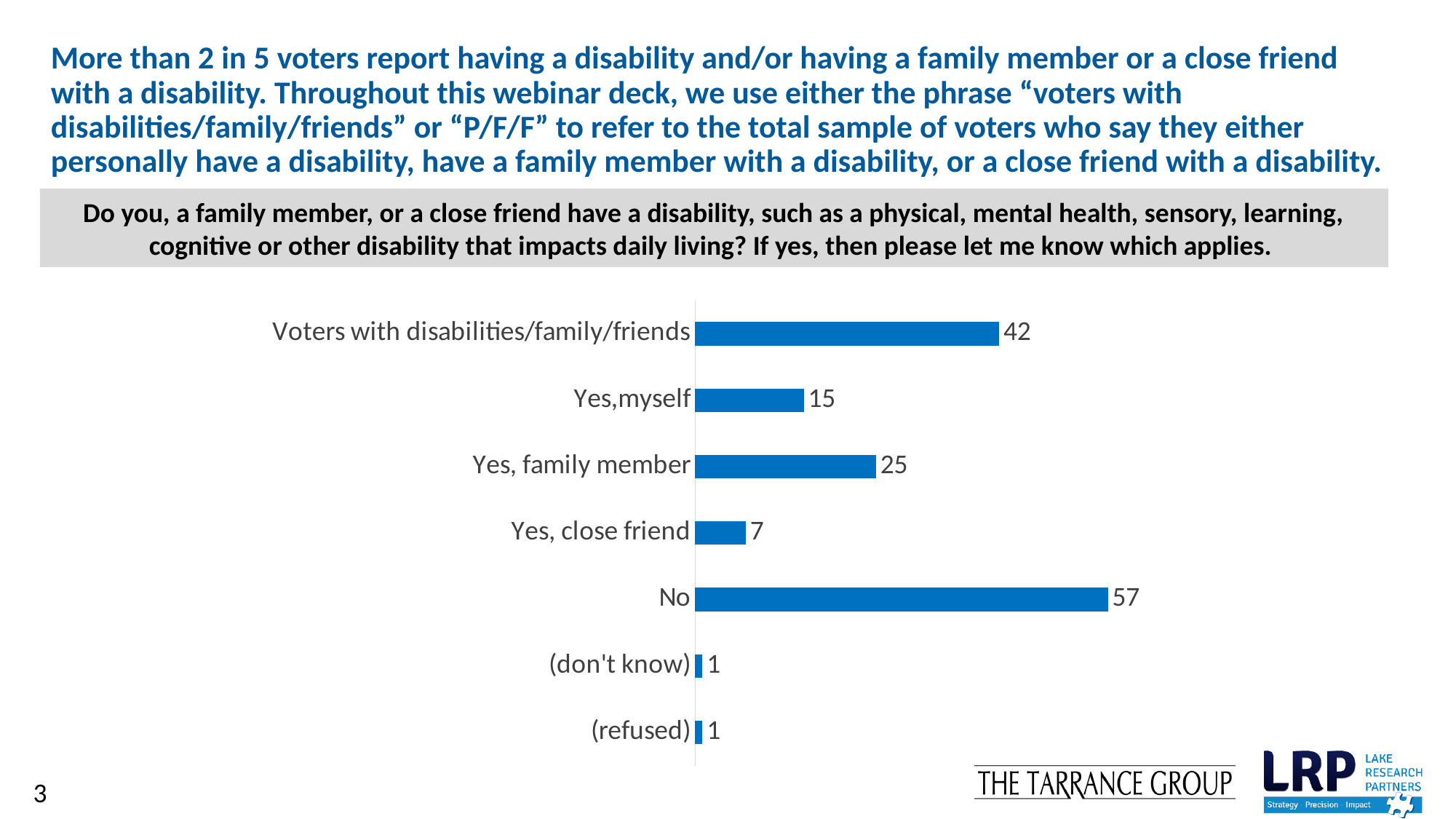
How many categories are shown in the chart? 7 What is the value for "Yes, close friend"? 7 What value is shown for "(don't know)"? 1 What is the difference between the values for "Yes, family member" and "Yes,myself"? 10 Which is larger, the value for "Yes,myself" or the value for "Yes, family member"? Yes, family member What is the value for "Yes, family member"? 25 What is the value for "Voters with disabilities/family/friends"? 42 What colour are the bars in the chart? Blue What kind of chart is shown on the slide? Bar chart What is the value for "No"? 57 What is the difference between the values for "No" and "Voters with disabilities/family/friends"? 15 Which category has the highest value? No